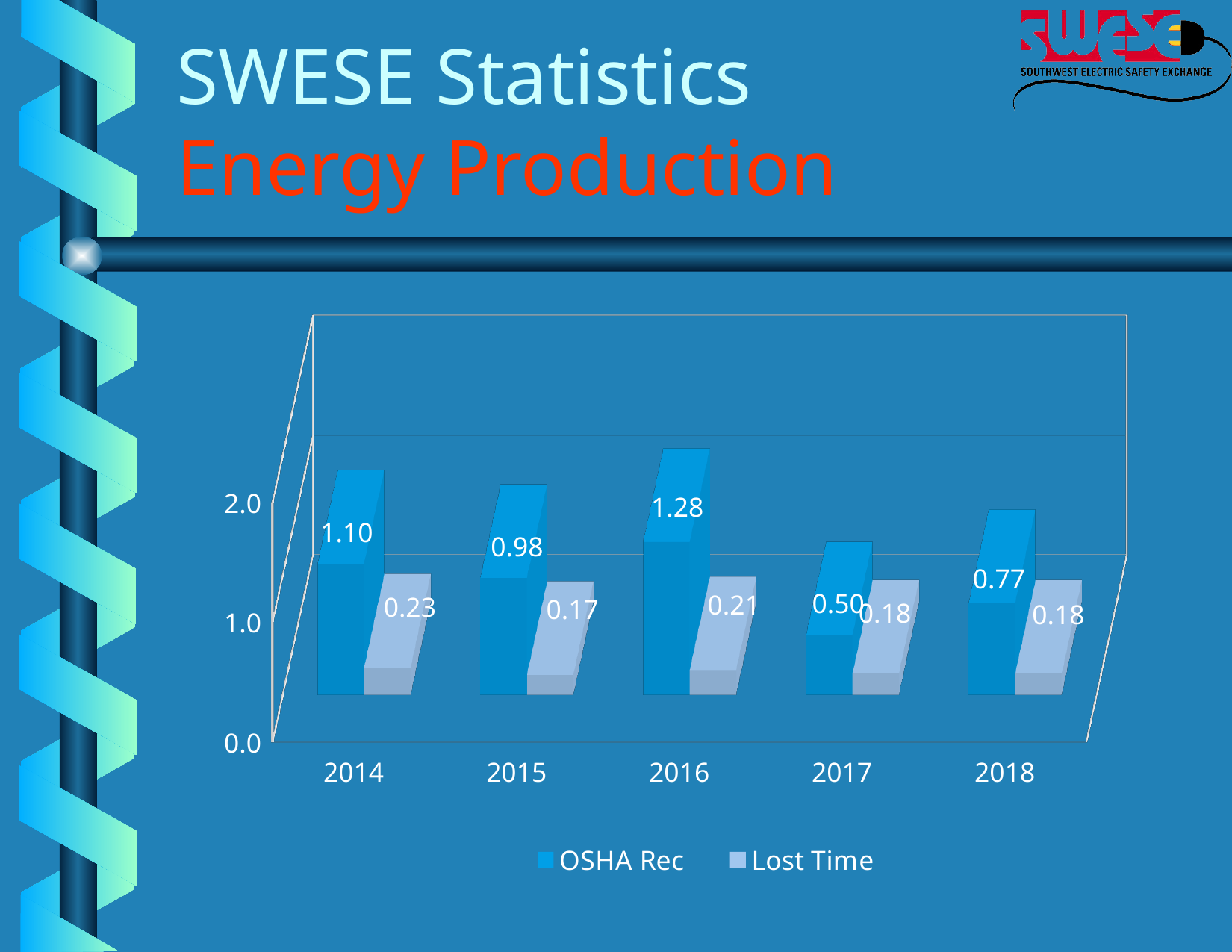
What kind of chart is shown on the slide? Bar chart Which year has the lowest Lost Time value? 2015 What is the OSHA Rec value for 2016? 1.28 How many series does the legend list? 2 Which year has the highest OSHA Rec value? 2016 How many years are shown on the x axis? 5 What is the Lost Time value for 2015? 0.17 Which is larger, the OSHA Rec value for 2014 or for 2018? 2014 What is the OSHA Rec value for 2017? 0.50 What is the difference between the OSHA Rec values for 2016 and 2017? 0.78 Which year has the lowest OSHA Rec value? 2017 What is the Lost Time value for 2014? 0.23